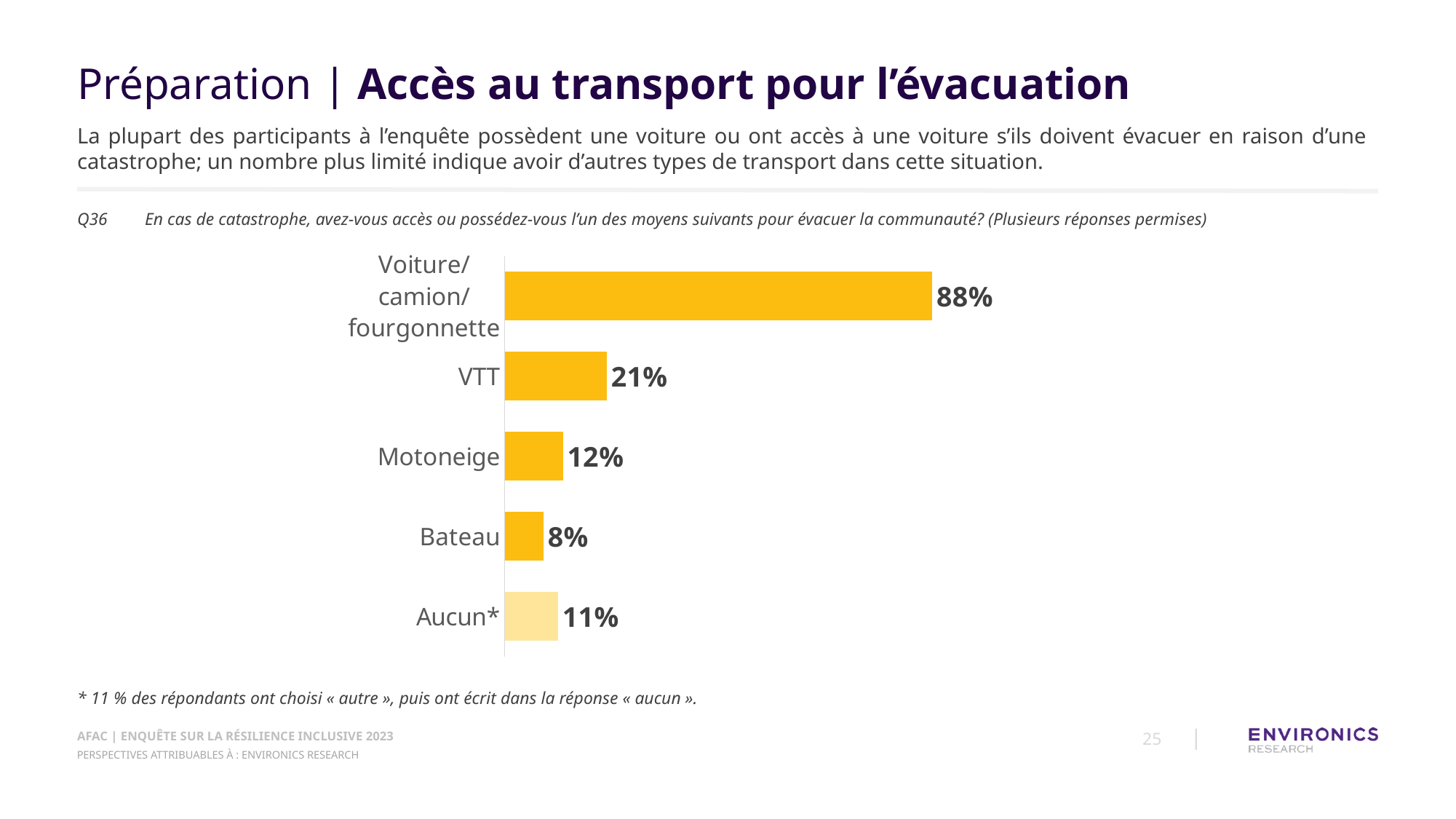
What kind of chart is shown on the slide? Bar chart How many categories are shown in the chart? 5 What is the value shown for Motoneige? 12% Which category has the lowest value in the chart? Bateau Which bar in the chart is shown in a lighter colour than the others? Aucun* Which is larger, the value for Motoneige or the value for Aucun*? Motoneige What is the value shown for VTT? 21% What is the value shown for Aucun*? 11% What percentage of respondents have access to a Voiture/camion/fourgonnette for evacuation? 88% What is the difference between the values for Voiture/camion/fourgonnette and VTT? 67% Which category has the highest value in the chart? Voiture/camion/fourgonnette What is the value shown for Bateau? 8%